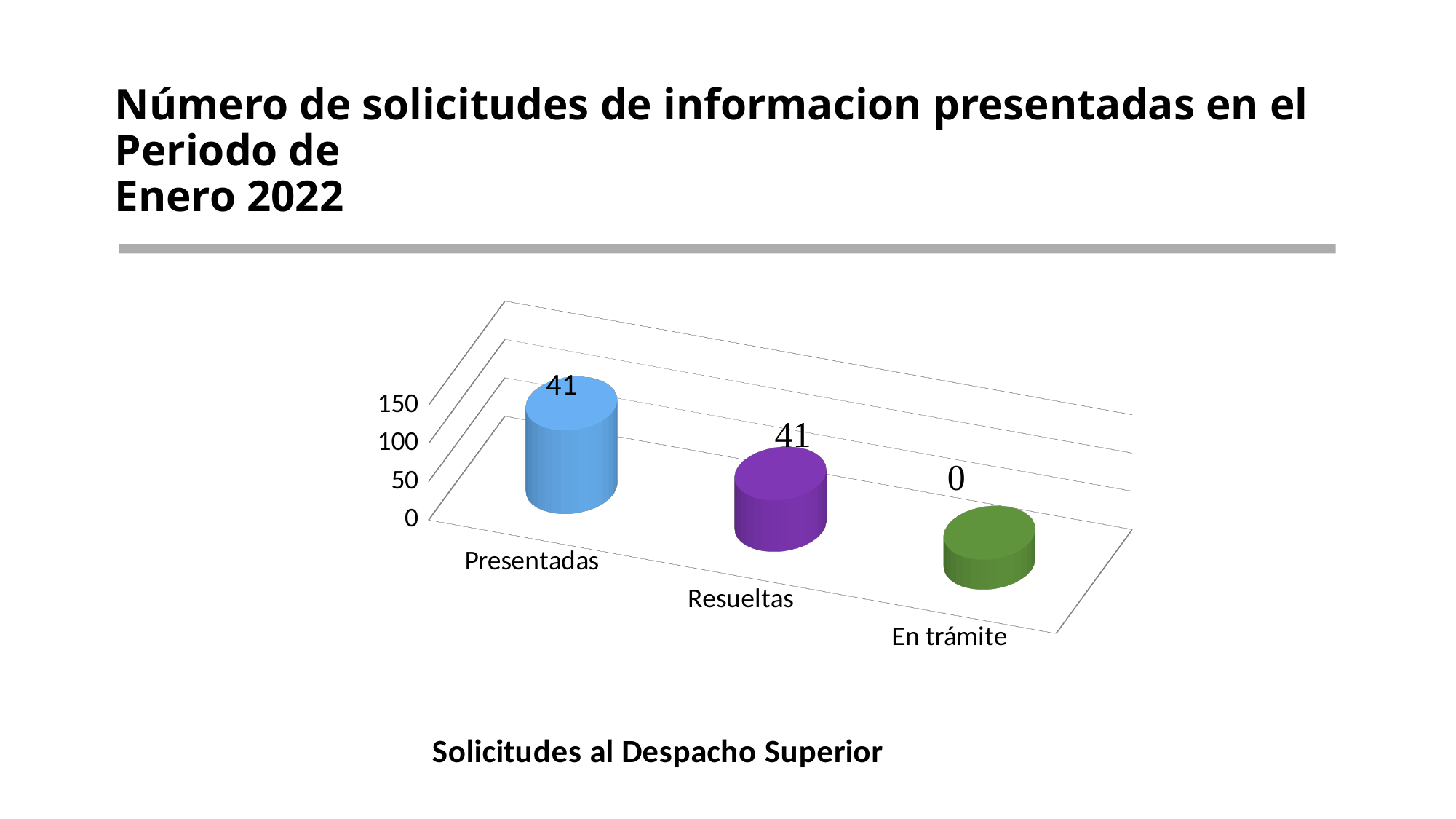
What is the title of the chart? Solicitudes al Despacho Superior Is the value for Presentadas greater or less than 50? greater Which is larger, the value for Resueltas or the value for En trámite? Resueltas What kind of chart is shown on the slide? bar chart How many categories are shown on the chart? 3 Which category has the lowest value? En trámite What colour is the bar for Resueltas? purple